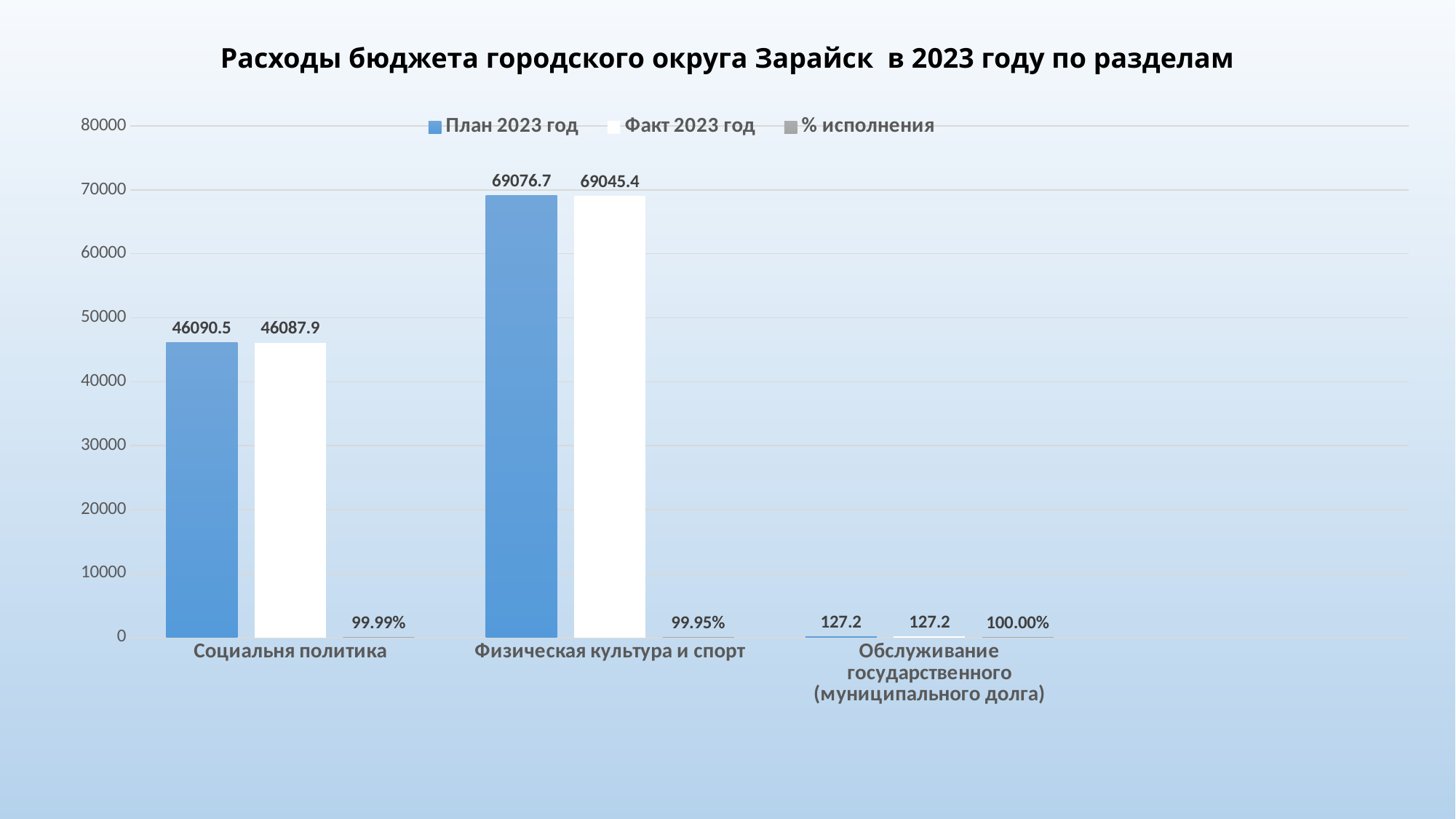
Is the Факт 2023 год value for Социальня политика greater or less than 50000? less What is the difference between the План 2023 год values for Физическая культура и спорт and Социальня политика? 22986.2 What is the % исполнения value for Физическая культура и спорт? 99.95% What is the План 2023 год value for Социальня политика? 46090.5 How many categories are shown on the x axis? 3 Which is larger: the Факт 2023 год value for Физическая культура и спорт or for Социальня политика? Физическая культура и спорт What is the Факт 2023 год value for Физическая культура и спорт? 69045.4 Which category has the lowest Факт 2023 год value? Обслуживание государственного (муниципального долга) Which category has the highest План 2023 год value? Физическая культура и спорт What is the % исполнения value for Обслуживание государственного (муниципального долга)? 100.00% How many series does the legend list? 3 What is the difference between the План 2023 год and Факт 2023 год values for Физическая культура и спорт? 31.3